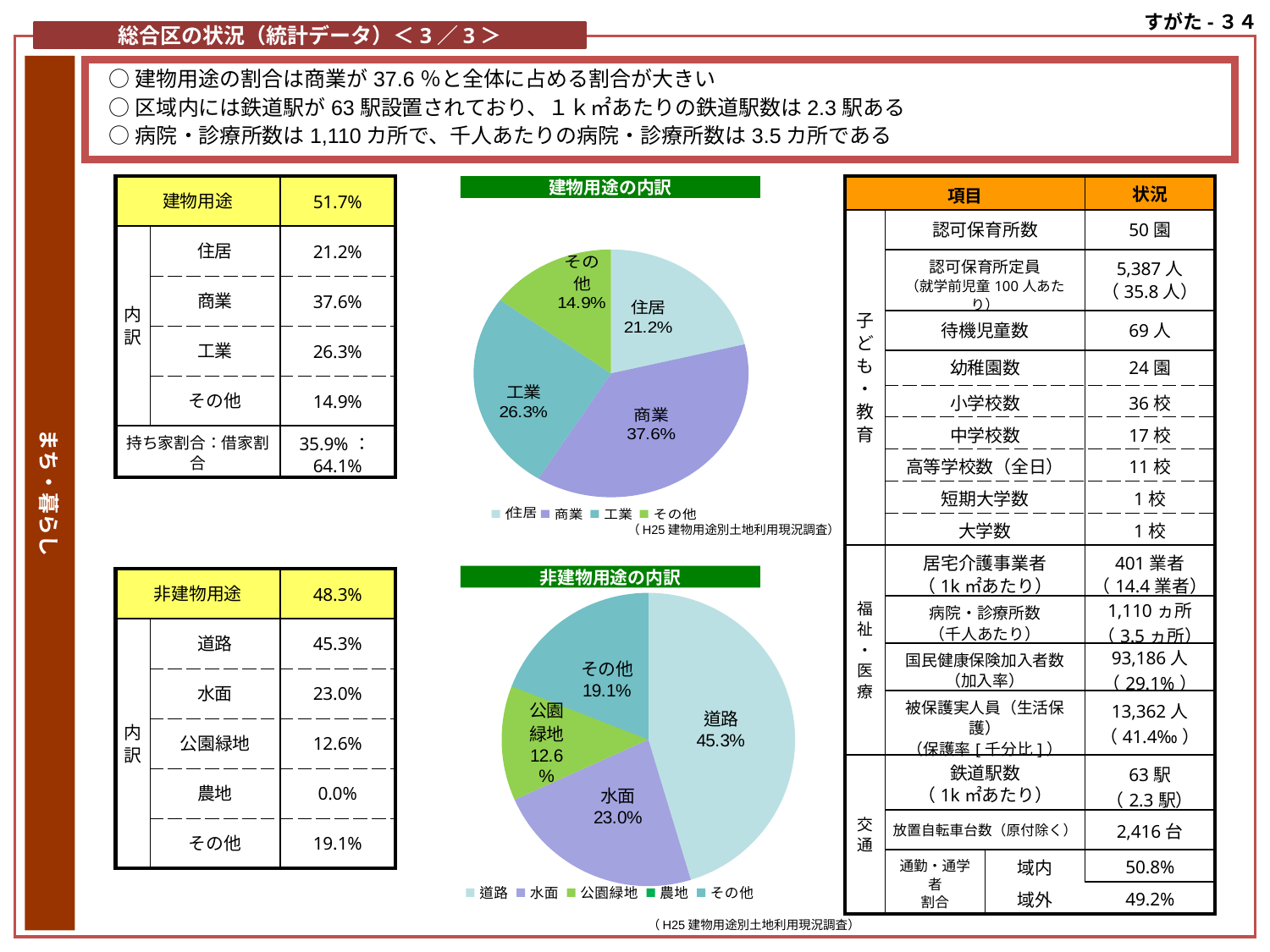
In the 建物用途の内訳 pie chart, what is the share for 工業? 26.3% In the 建物用途の内訳 pie chart, how many categories are shown in the legend? 4 In the 建物用途の内訳 pie chart, what is the difference between the shares of 商業 and 住居? 16.4% In the 非建物用途の内訳 pie chart, what is the share for 道路? 45.3% In the 建物用途の内訳 pie chart, which category has the smallest share? その他 In the 非建物用途の内訳 pie chart, what is the share for 公園緑地? 12.6% In the 建物用途の内訳 pie chart, which category has the largest share? 商業 What type of chart is used for 建物用途の内訳? Pie chart In the 非建物用途の内訳 pie chart, which is larger, 水面 or その他? 水面 In the 建物用途の内訳 pie chart, what is the share for 商業? 37.6% In the 非建物用途の内訳 pie chart, which category has the largest share? 道路 In the 非建物用途の内訳 pie chart, how many categories are listed in the legend? 5